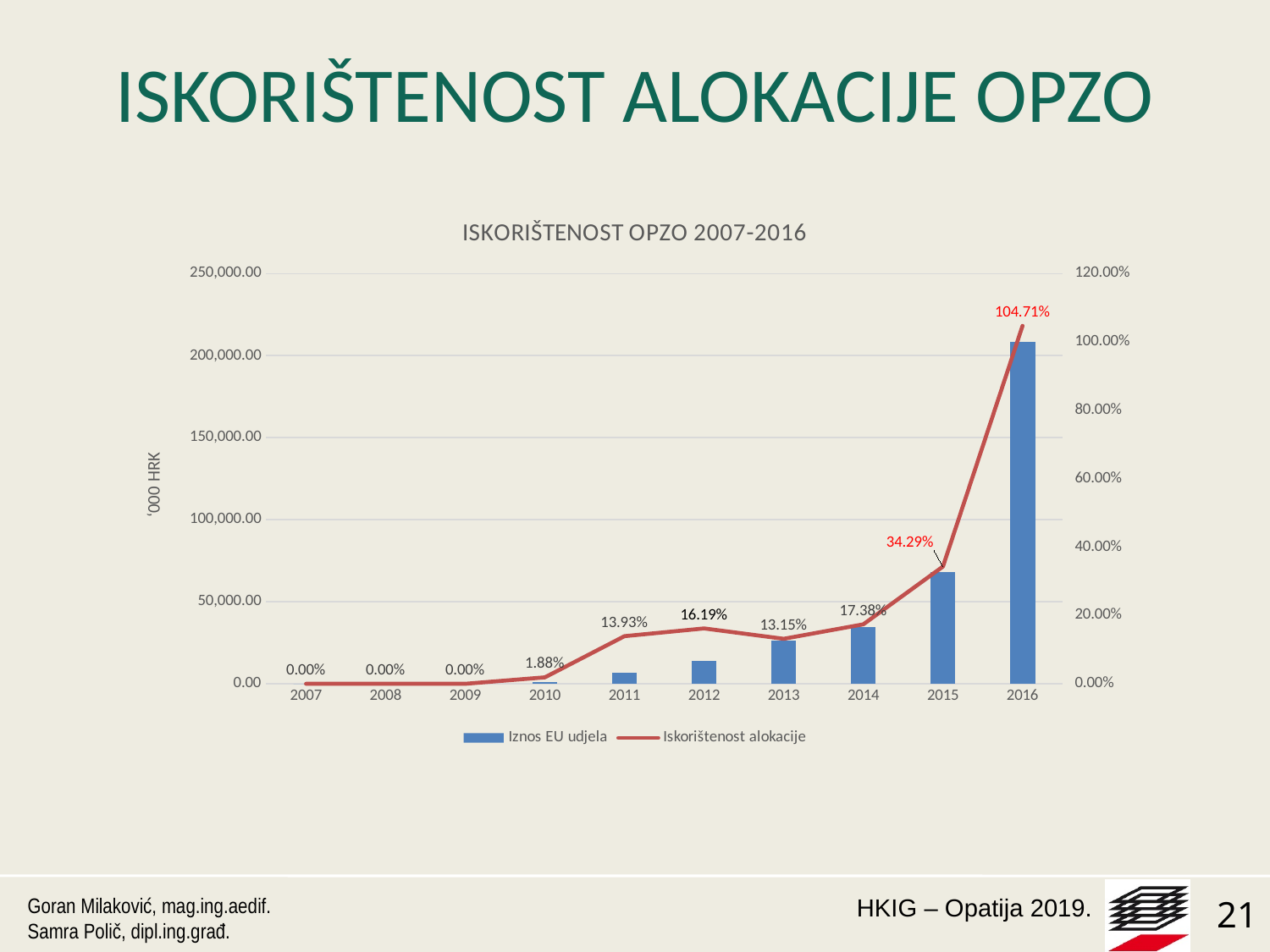
What is the value of Iskorištenost alokacije for 2015? 34.29% What is the value of Iskorištenost alokacije for 2011? 13.93% What is the value of Iskorištenost alokacije for 2016? 104.71% How many years are shown on the x axis? 10 Is the Iznos EU udjela bar for 2016 greater or less than 200,000.00? greater What is the difference in Iskorištenost alokacije between 2016 and 2015? 70.42% Which year has the highest Iskorištenost alokacije? 2016 Is the Iznos EU udjela bar for 2014 greater or less than 50,000.00? less What is the value of Iskorištenost alokacije for 2010? 1.88% How many series does the legend list? 2 What kind of chart is shown? Combination bar and line chart Which year has the larger Iskorištenost alokacije, 2012 or 2013? 2012